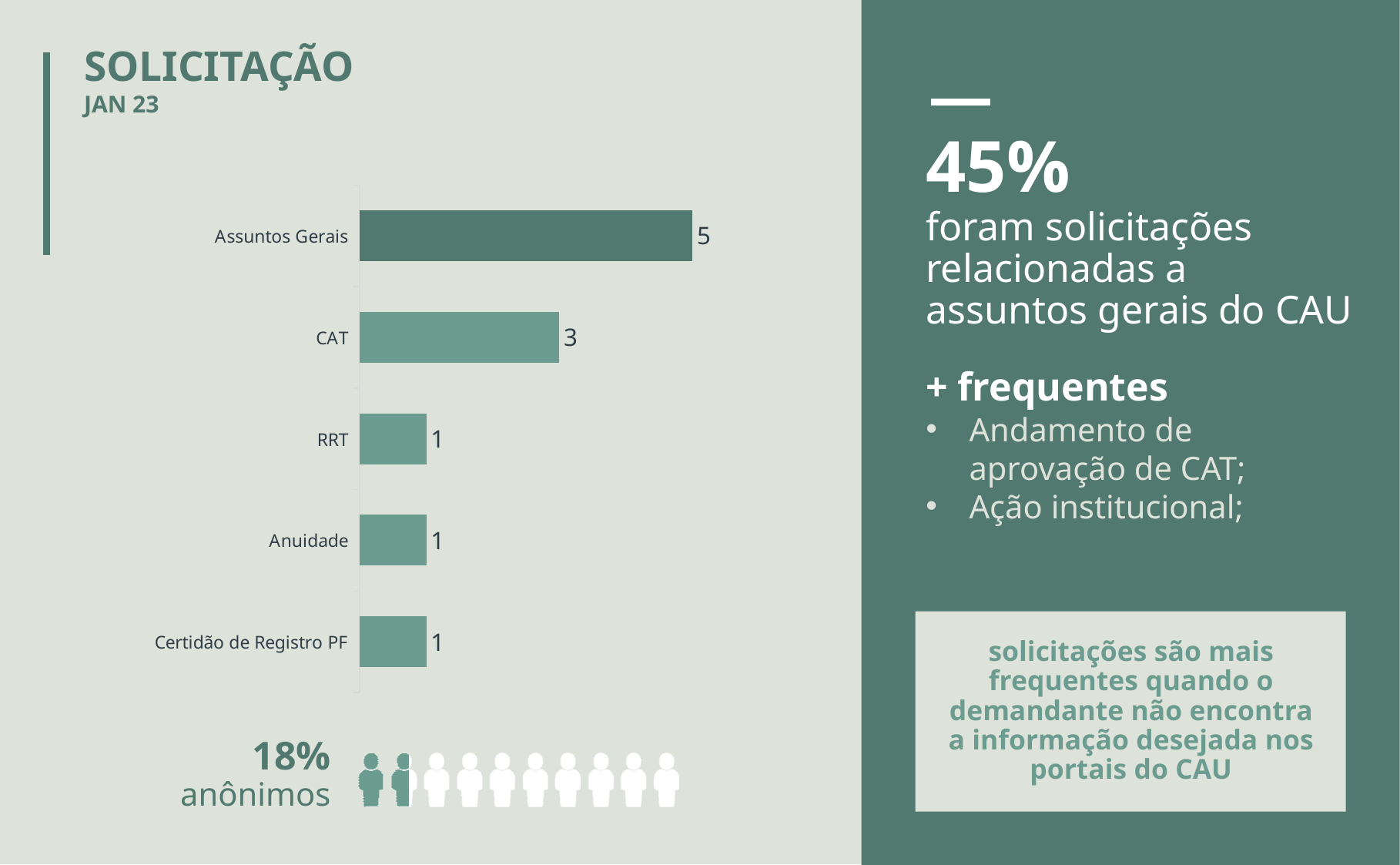
Which category has the highest value? Assuntos Gerais What kind of chart is shown on the slide? Bar chart Which is larger, the value for CAT or the value for RRT? CAT What is the total of all the values shown in the chart? 11 What is the value for Certidão de Registro PF? 1 How many categories are shown in the chart? 5 What is the value for RRT? 1 What is the difference between the values for CAT and Anuidade? 2 What is the value for CAT? 3 What is the title of the slide containing the chart? SOLICITAÇÃO What is the difference between the values for Assuntos Gerais and CAT? 2 What is the value for Assuntos Gerais? 5